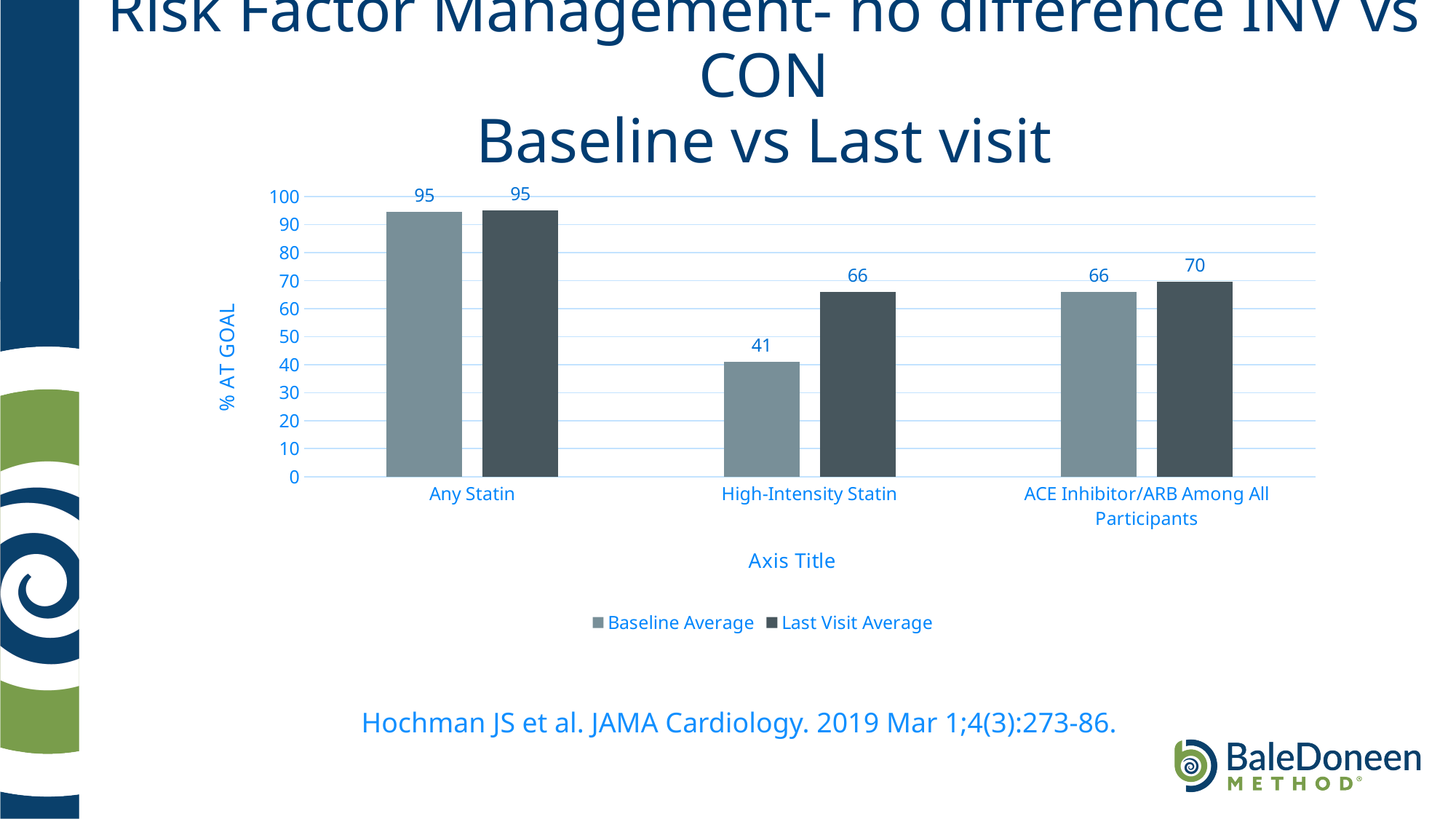
What is the difference between the Last Visit Average and Baseline Average for High-Intensity Statin? 25 How many categories are shown on the x axis? 3 What is the Last Visit Average value for ACE Inhibitor/ARB Among All Participants? 70 Which category has the highest Last Visit Average value? Any Statin What kind of chart is shown on the slide? Bar chart What is the difference between the Last Visit Average and Baseline Average for ACE Inhibitor/ARB Among All Participants? 4 What is the Baseline Average value for High-Intensity Statin? 41 What is the Baseline Average value for Any Statin? 95 How many series does the legend list? 2 Which category has the lowest Baseline Average value? High-Intensity Statin What is the Last Visit Average value for High-Intensity Statin? 66 Which is larger for High-Intensity Statin: the Baseline Average or the Last Visit Average? Last Visit Average